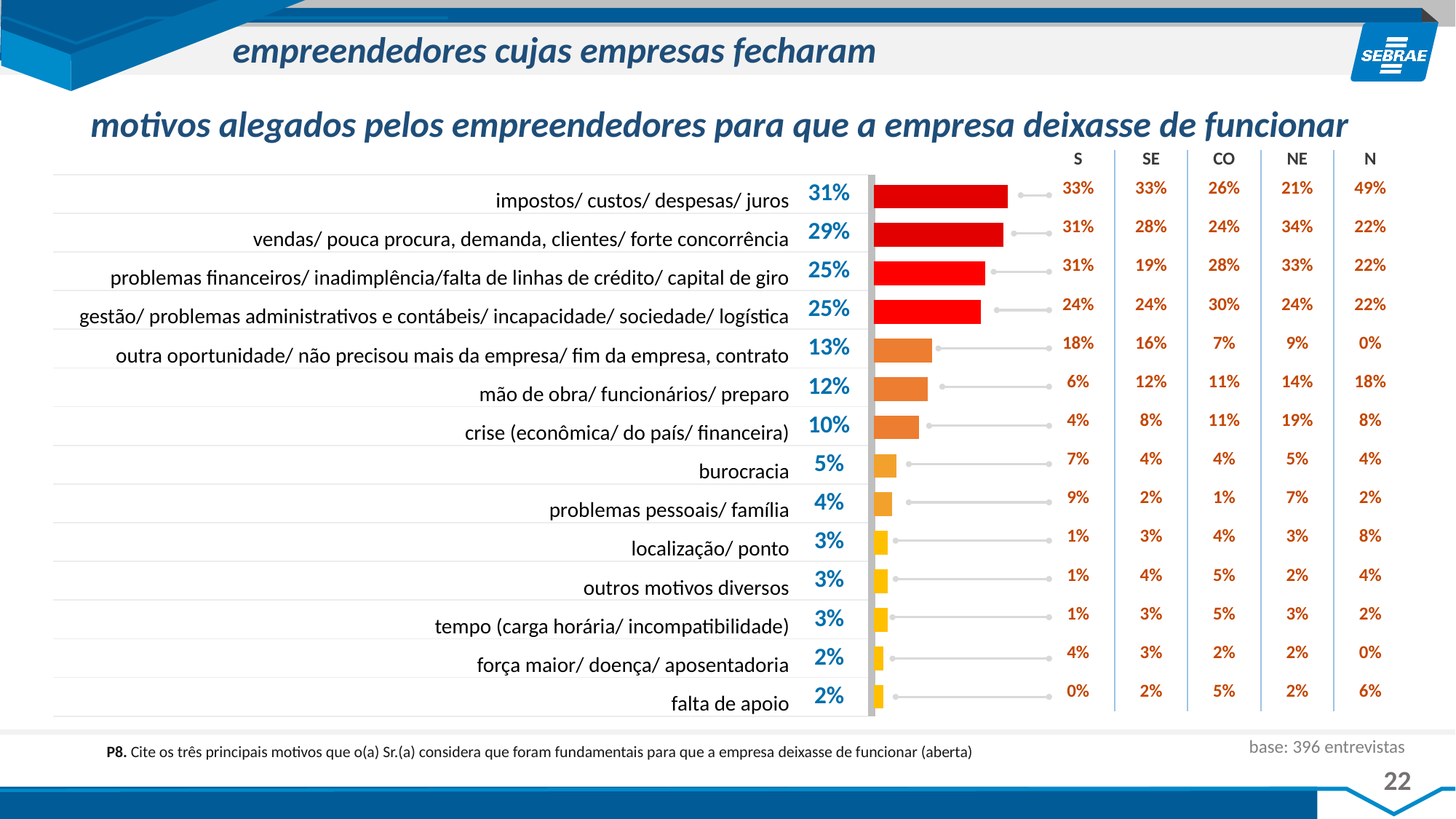
What percentage is shown for "crise (econômica/ do país/ financeira)"? 10% How many regional columns (S, SE, CO, NE, N) are shown to the right of the bar chart? 5 What type of chart is used to show the reasons for the company closing? Bar chart Which reason has the highest percentage in the bar chart? impostos/ custos/ despesas/ juros What percentage is shown for "burocracia"? 5% What is the difference in percentage points between "vendas/ pouca procura, demanda, clientes/ forte concorrência" and "mão de obra/ funcionários/ preparo"? 17 percentage points In the regional table, what is the value for "crise (econômica/ do país/ financeira)" in region NE? 19% How many reasons (categories) are listed in the bar chart? 14 In the regional table, what is the value for "impostos/ custos/ despesas/ juros" in region N? 49% Do the bar values increase or decrease from the top of the chart to the bottom? Decrease Which has a larger percentage: "outra oportunidade/ não precisou mais da empresa/ fim da empresa, contrato" or "problemas pessoais/ família"? outra oportunidade/ não precisou mais da empresa/ fim da empresa, contrato What percentage is shown for "impostos/ custos/ despesas/ juros"? 31%